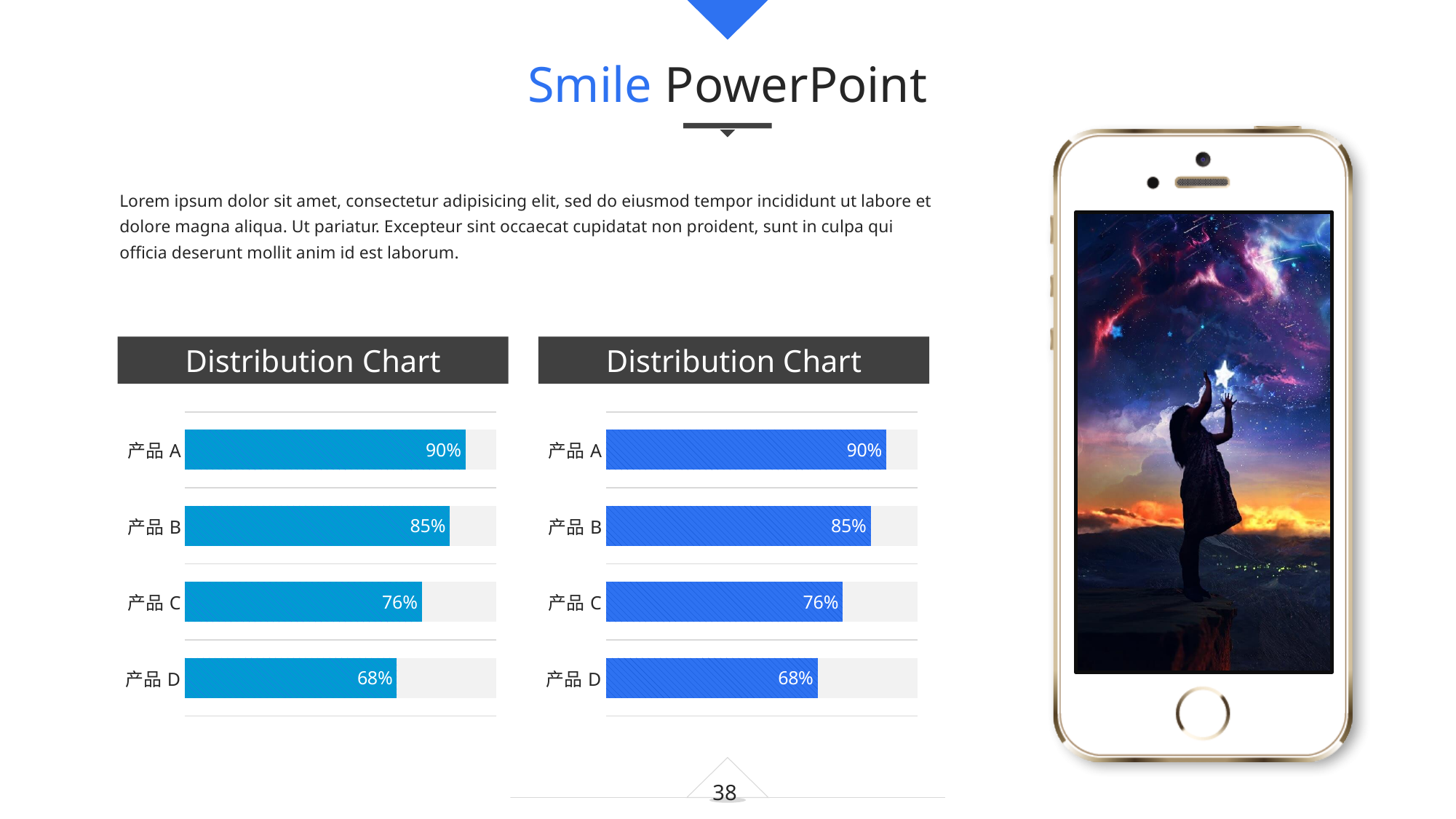
What kind of chart is the right Distribution Chart? Bar chart How many products are shown in the left Distribution Chart? 4 In the left Distribution Chart, do the values rise or fall going from 产品 A down to 产品 D? Fall In the right Distribution Chart, what is the value for 产品 B? 85% In the right Distribution Chart, which product has the lowest value? 产品 D In the left Distribution Chart, what is the value for 产品 A? 90% In the left Distribution Chart, what is the difference between the values for 产品 A and 产品 D? 22% In the left Distribution Chart, what is the value for 产品 D? 68% In the right Distribution Chart, what is the value for 产品 C? 76% In the right Distribution Chart, what is the difference between the values for 产品 B and 产品 C? 9% In the right Distribution Chart, which is larger, the value for 产品 B or 产品 C? 产品 B In the left Distribution Chart, which product has the highest value? 产品 A